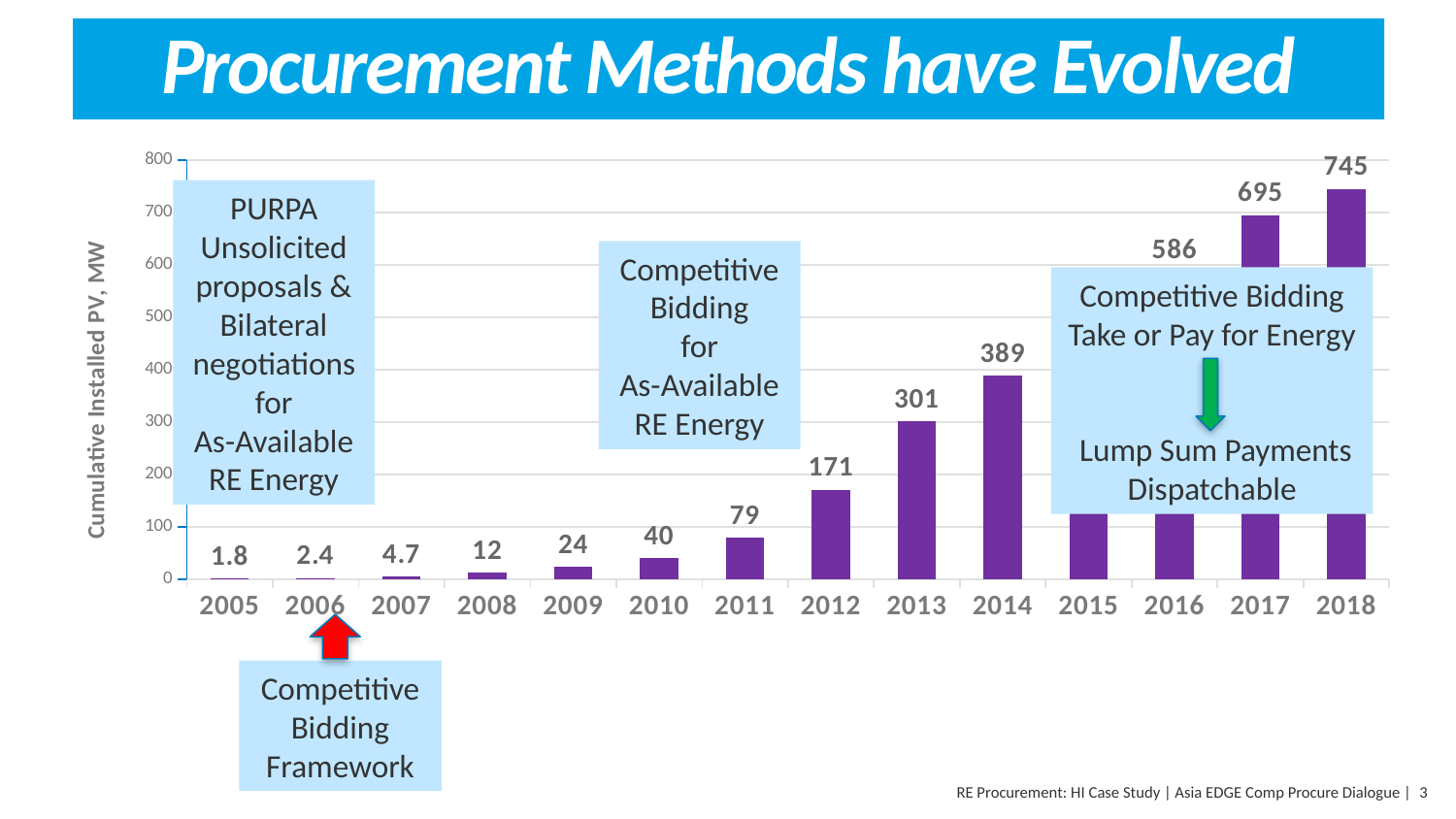
Which year has the highest cumulative installed PV? 2018 Which year has the larger value, 2011 or 2012? 2012 Do the values rise or fall from 2005 to 2018? rise What is the cumulative installed PV value for 2005? 1.8 What is the difference between the 2018 and 2017 values? 50 What kind of chart is shown on the slide? bar chart What is the cumulative installed PV value for 2013? 301 What is the cumulative installed PV value for 2018? 745 What is the difference between the 2014 and 2013 values? 88 What is the cumulative installed PV value for 2010? 40 How many years are shown on the x axis of the chart? 14 Which year has the lowest cumulative installed PV? 2005